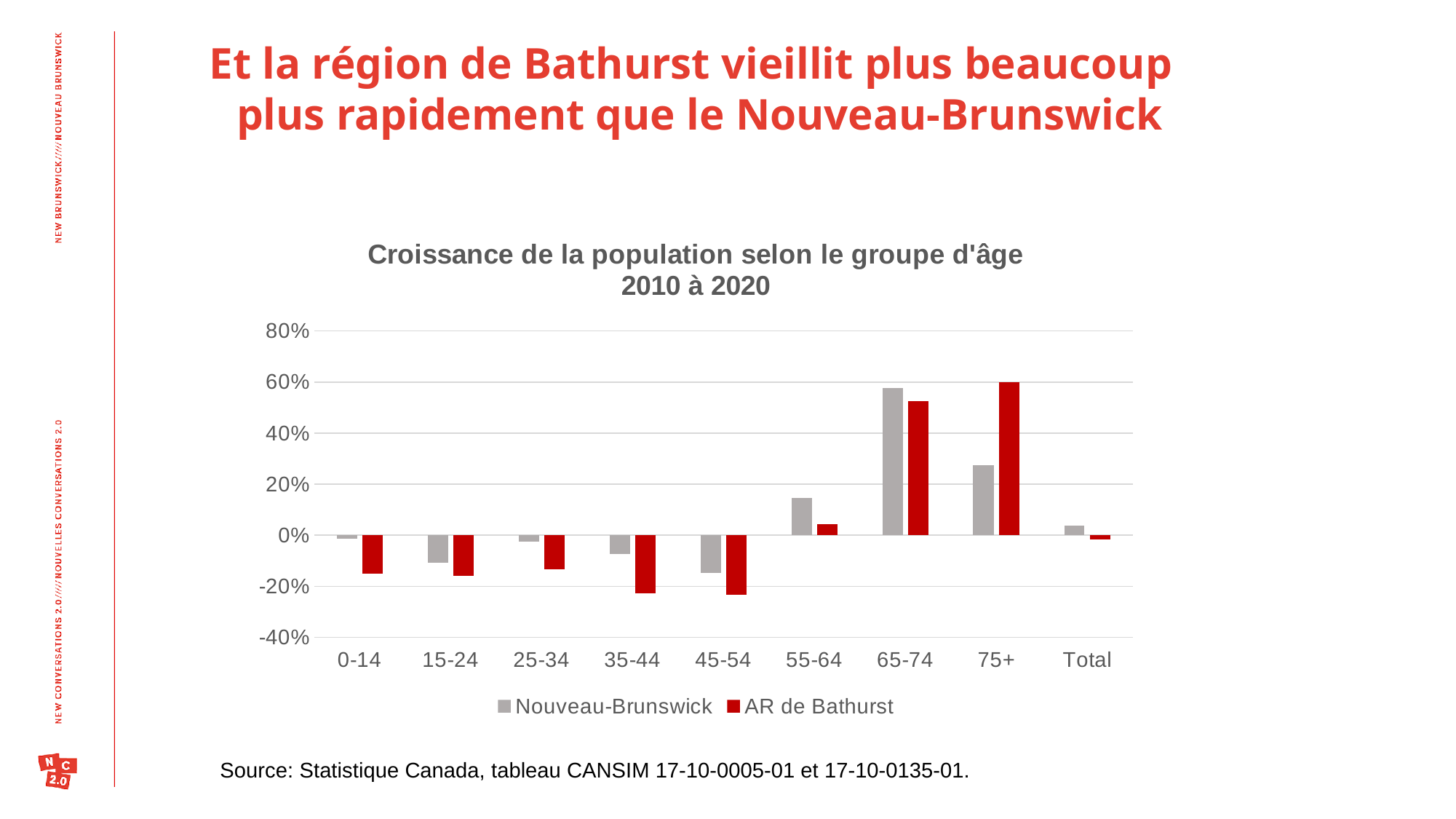
For which category is the AR de Bathurst bar the highest? 75+ What kind of chart is shown on the slide? bar chart What colour are the AR de Bathurst bars? red In the 75+ category, which series has the larger value, Nouveau-Brunswick or AR de Bathurst? AR de Bathurst How many age-group categories are shown on the x axis, including Total? 9 Is the Nouveau-Brunswick value for 55-64 greater or less than 20%? less In the 65-74 category, which series has the larger value, Nouveau-Brunswick or AR de Bathurst? Nouveau-Brunswick How many series does the legend list? 2 Is the AR de Bathurst value for 75+ greater or less than 40%? greater Is the AR de Bathurst value for 45-54 greater or less than -20%? less For which category is the Nouveau-Brunswick bar the highest? 65-74 For which category is the Nouveau-Brunswick bar the lowest? 45-54